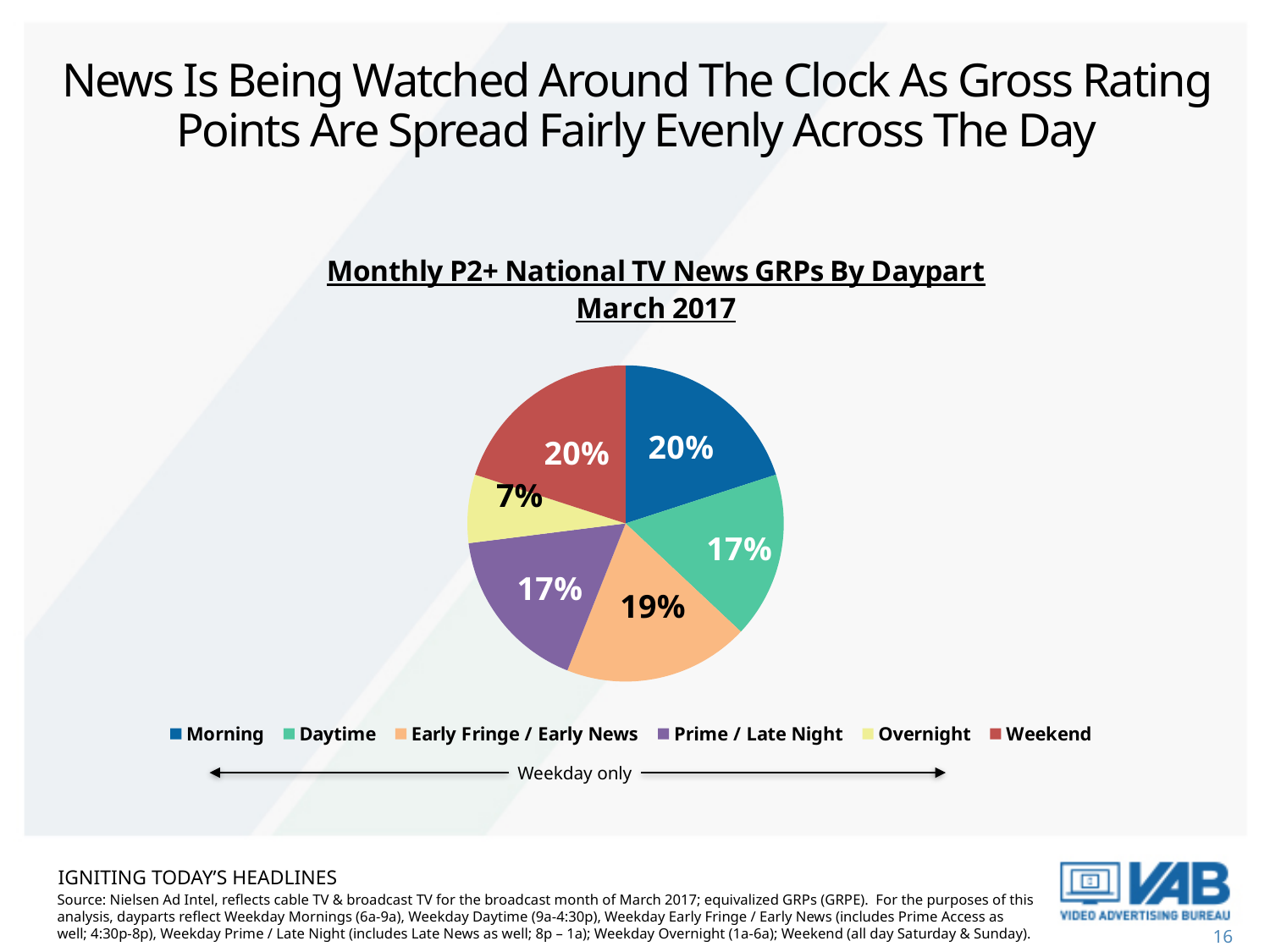
What is the difference in percentage points between the Early Fringe / Early News share and the Overnight share? 12 What share of GRPs does the Daytime daypart account for? 17% What share of GRPs does the Weekend daypart account for? 20% What share of GRPs does Early Fringe / Early News account for? 19% What share of GRPs does Prime / Late Night account for? 17% What share of GRPs does the Morning daypart account for? 20% What share of GRPs does the Overnight daypart account for? 7% What is the title of the pie chart? Monthly P2+ National TV News GRPs By Daypart March 2017 What kind of chart is shown on the slide? Pie chart Which daypart has the smallest share of GRPs? Overnight How many dayparts are shown in the pie chart? 6 Which has a larger share of GRPs, Early Fringe / Early News or Daytime? Early Fringe / Early News